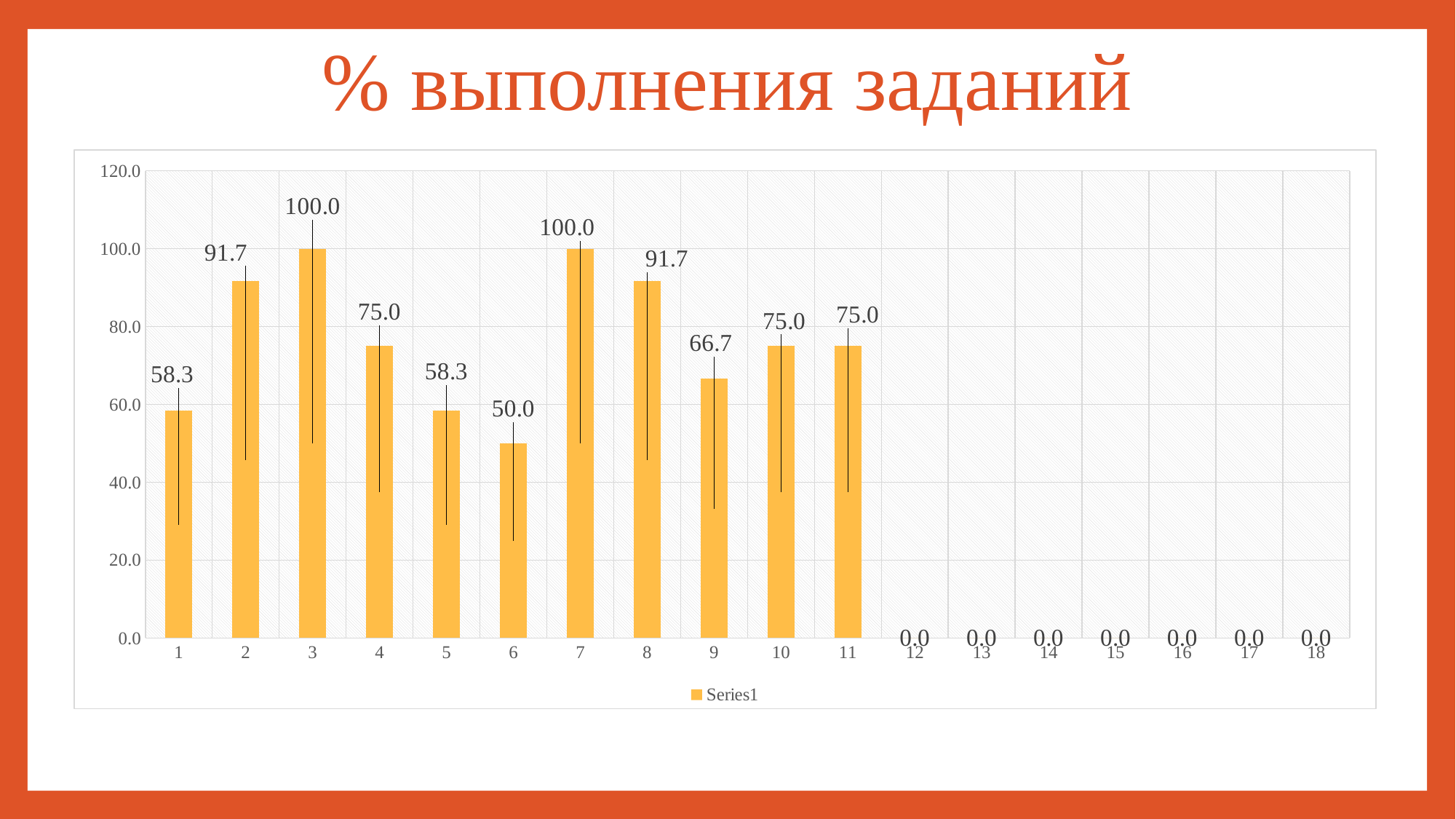
How many categories are shown on the x axis? 18 Among categories 1 to 11, which has the lowest value? 6 How many series does the legend list? 1 Which categories have the highest value? 3 and 7 What is the title of the slide above the chart? % выполнения заданий What is the value for category 6? 50.0 What is the difference between the values for category 2 and category 4? 16.7 What is the value for category 14? 0.0 What is the value for category 9? 66.7 What is the value for category 1? 58.3 What kind of chart is shown on the slide? bar chart Which is larger, the value for category 8 or the value for category 10? category 8